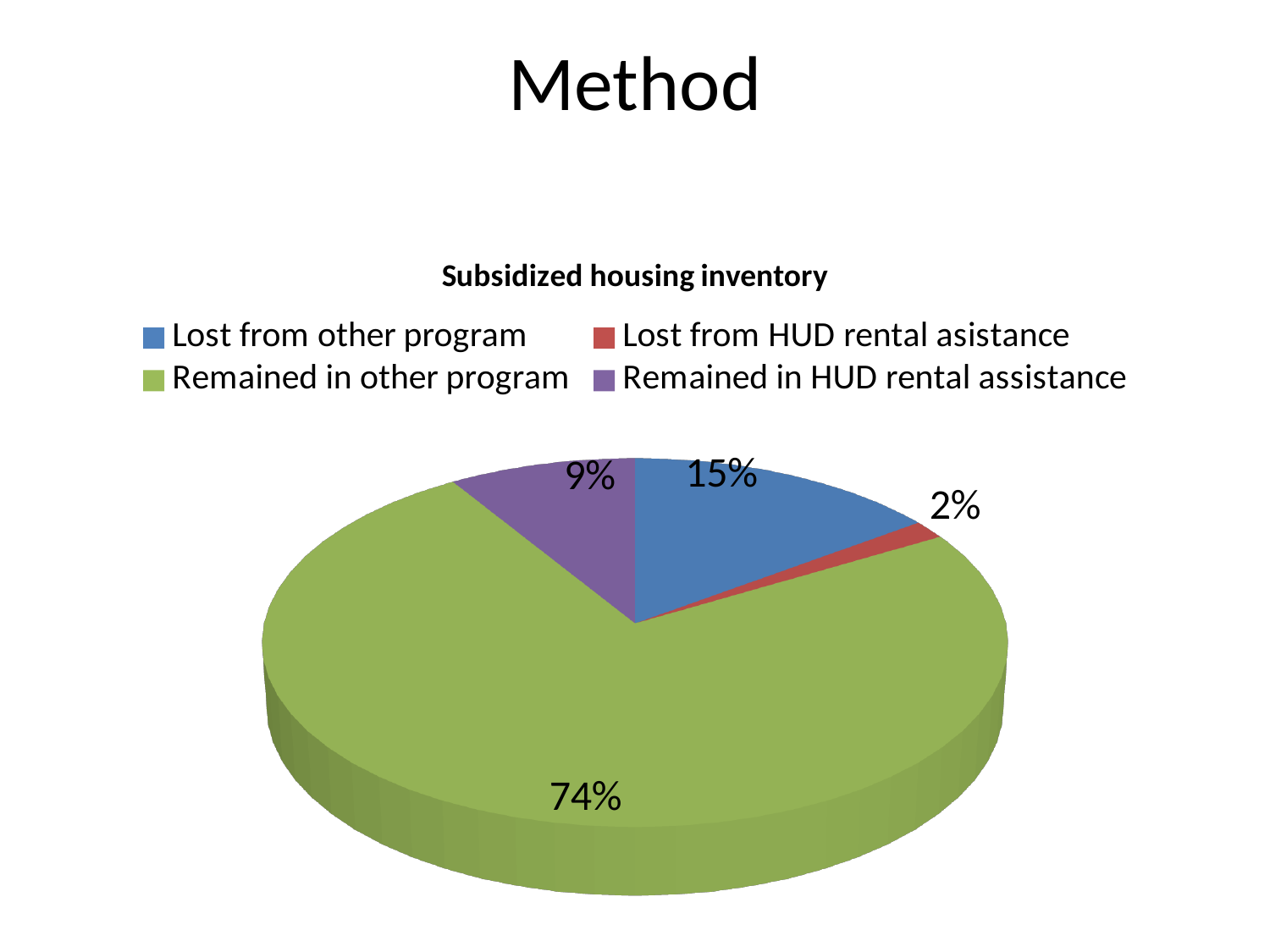
What share of the pie is 'Lost from HUD rental asistance'? 2% What is the title of the chart? Subsidized housing inventory What kind of chart is shown on the slide? Pie chart What share of the pie is 'Remained in HUD rental assistance'? 9% Which is larger, 'Lost from other program' or 'Remained in HUD rental assistance'? Lost from other program What is the difference in percentage points between 'Lost from other program' and 'Remained in HUD rental assistance'? 6 How many categories does the legend list? 4 Which category has the smallest slice of the pie? Lost from HUD rental asistance Which category has the largest slice of the pie? Remained in other program What share of the pie is 'Remained in other program'? 74% What colour is the slice for 'Remained in HUD rental assistance'? Purple